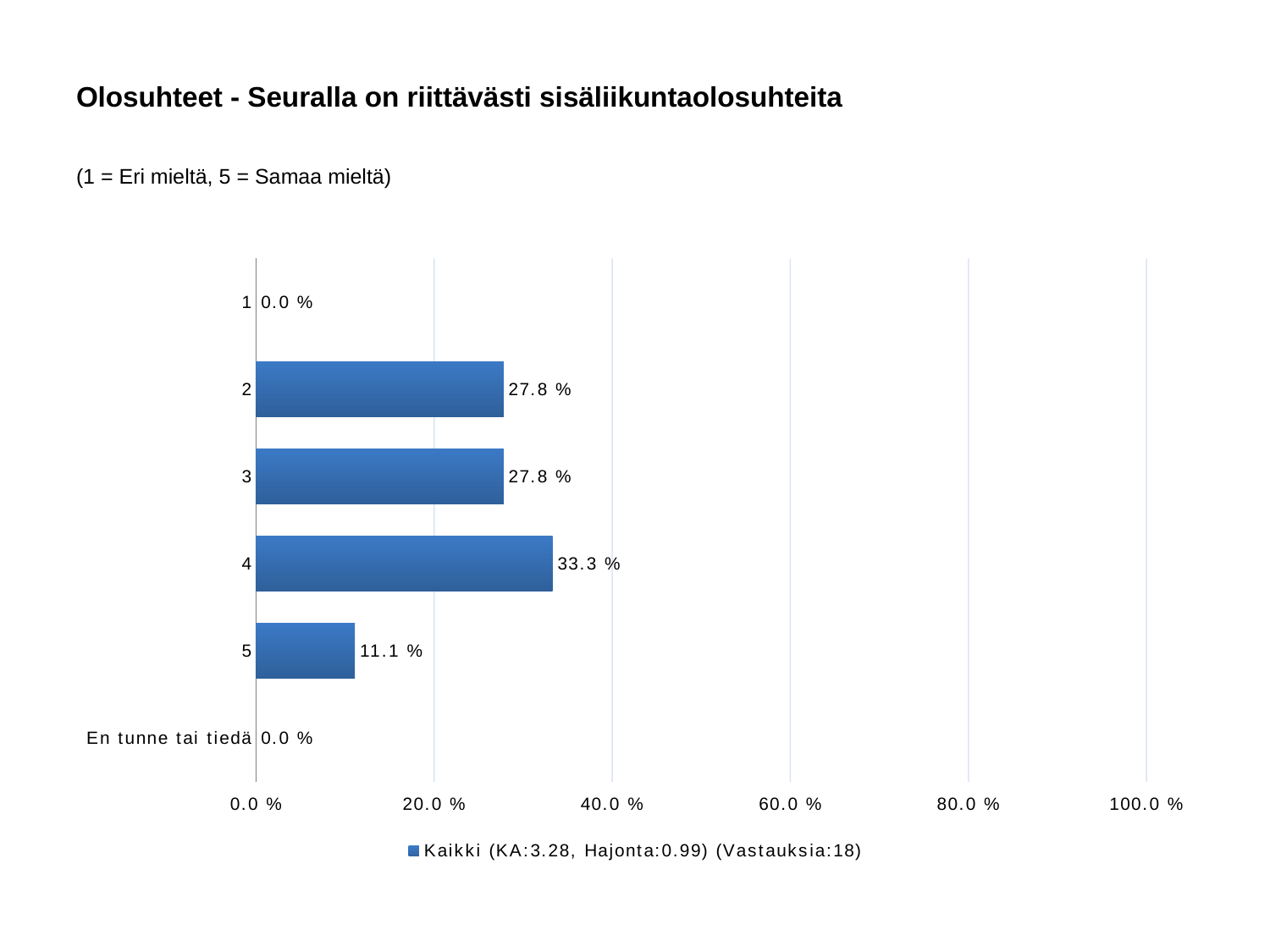
How many categories are shown on the chart? 6 What is the value for category 4? 33.3 % Is the value for category 4 greater or less than 20.0 %? greater Which is larger, the value for category 3 or the value for category 5? 3 Which category has the highest value? 4 What kind of chart is shown on the slide? bar chart What is the value for 'En tunne tai tiedä'? 0.0 % What is the difference between the values for category 4 and category 5? 22.2 % What is the title of the chart? Olosuhteet - Seuralla on riittävästi sisäliikuntaolosuhteita What is the value for category 5? 11.1 % What is the value for category 2? 27.8 % How many series does the legend list? 1